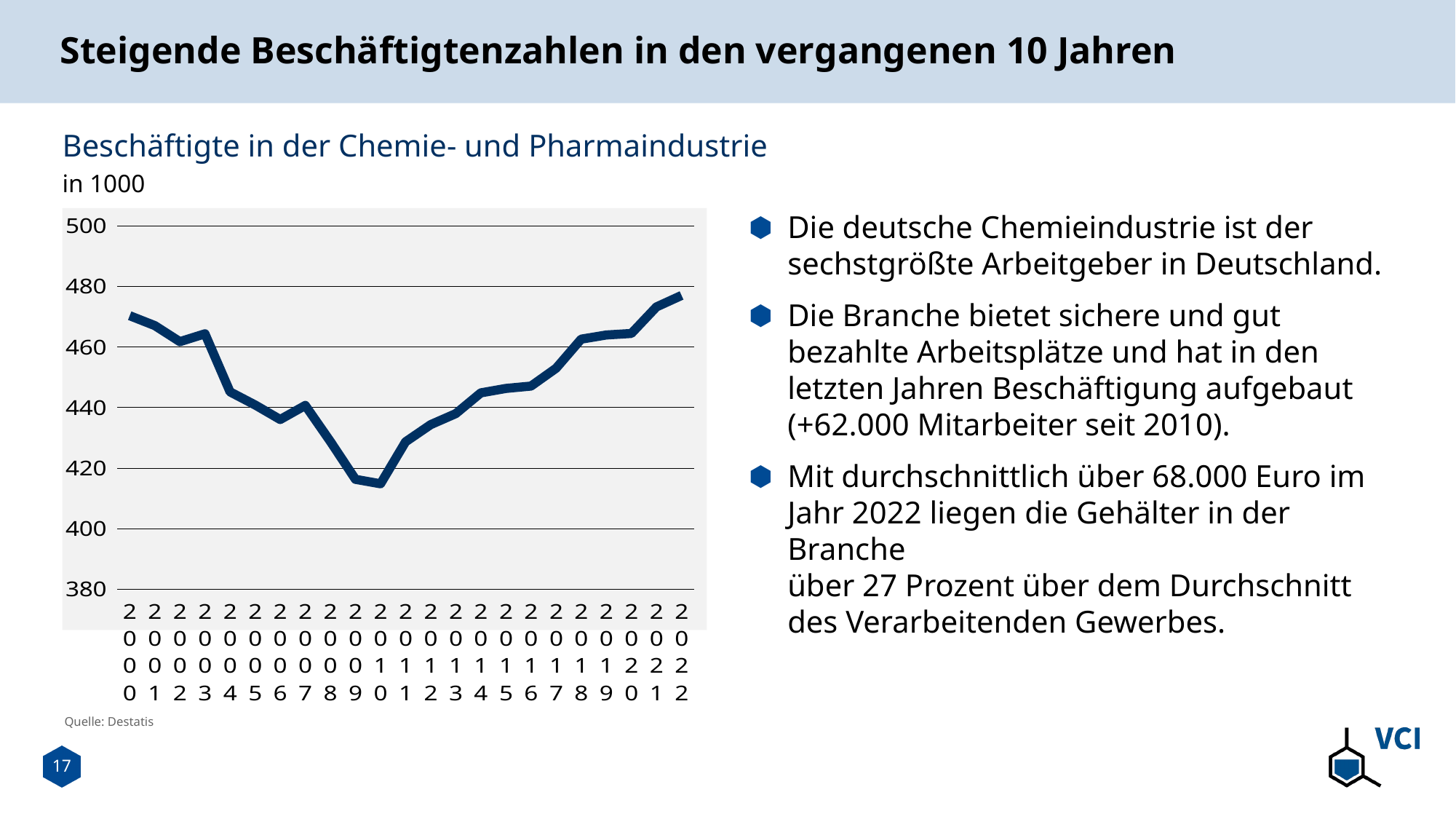
What kind of chart is shown on the slide? line chart What is the title of the chart? Beschäftigte in der Chemie- und Pharmaindustrie Which year has the lowest value in the chart? 2010 Is the value for 2000 greater or less than 460? greater Which is larger, the value for 2000 or the value for 2009? 2000 Is the value for 2022 greater or less than 480? less In what unit are the chart values given? in 1000 How many years are plotted on the x axis of the chart? 23 Is the value for 2010 greater or less than 420? less Do the values rise or fall from 2010 to 2022? rise Which year has the highest value in the chart? 2022